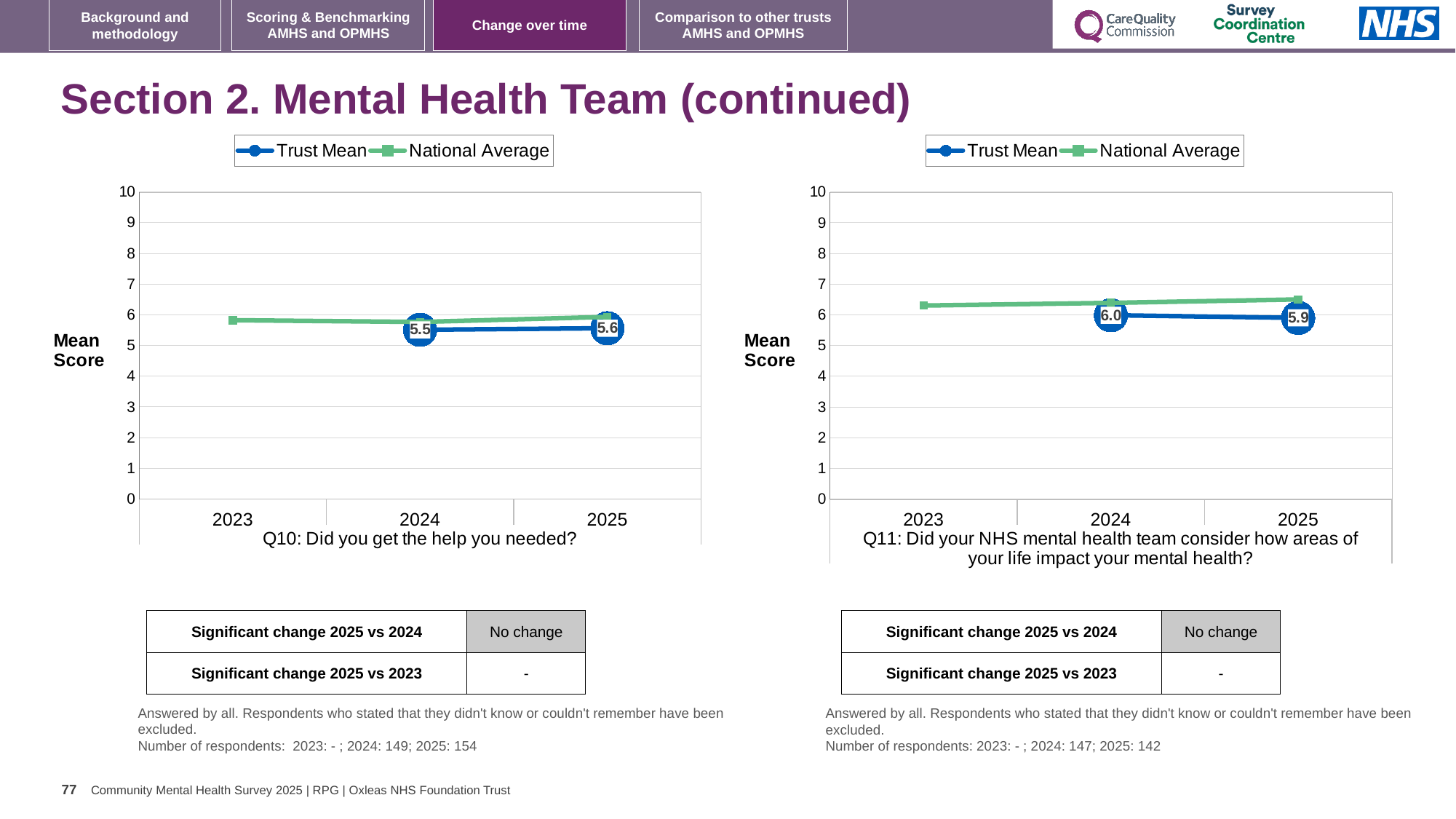
In the Q11 chart on the right, does the Trust Mean rise or fall from 2024 to 2025? fall How many series does the legend of the Q11 chart on the right list? 2 In the Q11 chart on the right, what is the Trust Mean score for 2024? 6.0 In the Q11 chart on the right, what is the Trust Mean score for 2025? 5.9 In the Q10 chart on the left, what is the Trust Mean score for 2024? 5.5 In the Q10 chart on the left, what is the Trust Mean score for 2025? 5.6 In the Q11 chart on the right, which year has the higher Trust Mean, 2024 or 2025? 2024 How many years are shown on the x axis of the Q10 chart on the left? 3 What kind of chart is the Q10 chart on the left? line chart In the Q11 chart on the right, is the National Average value for 2025 greater or less than 5? greater In the Q10 chart on the left, by how much did the Trust Mean change from 2024 to 2025? 0.1 In the Q10 chart on the left, is the National Average value for 2023 greater or less than 7? less